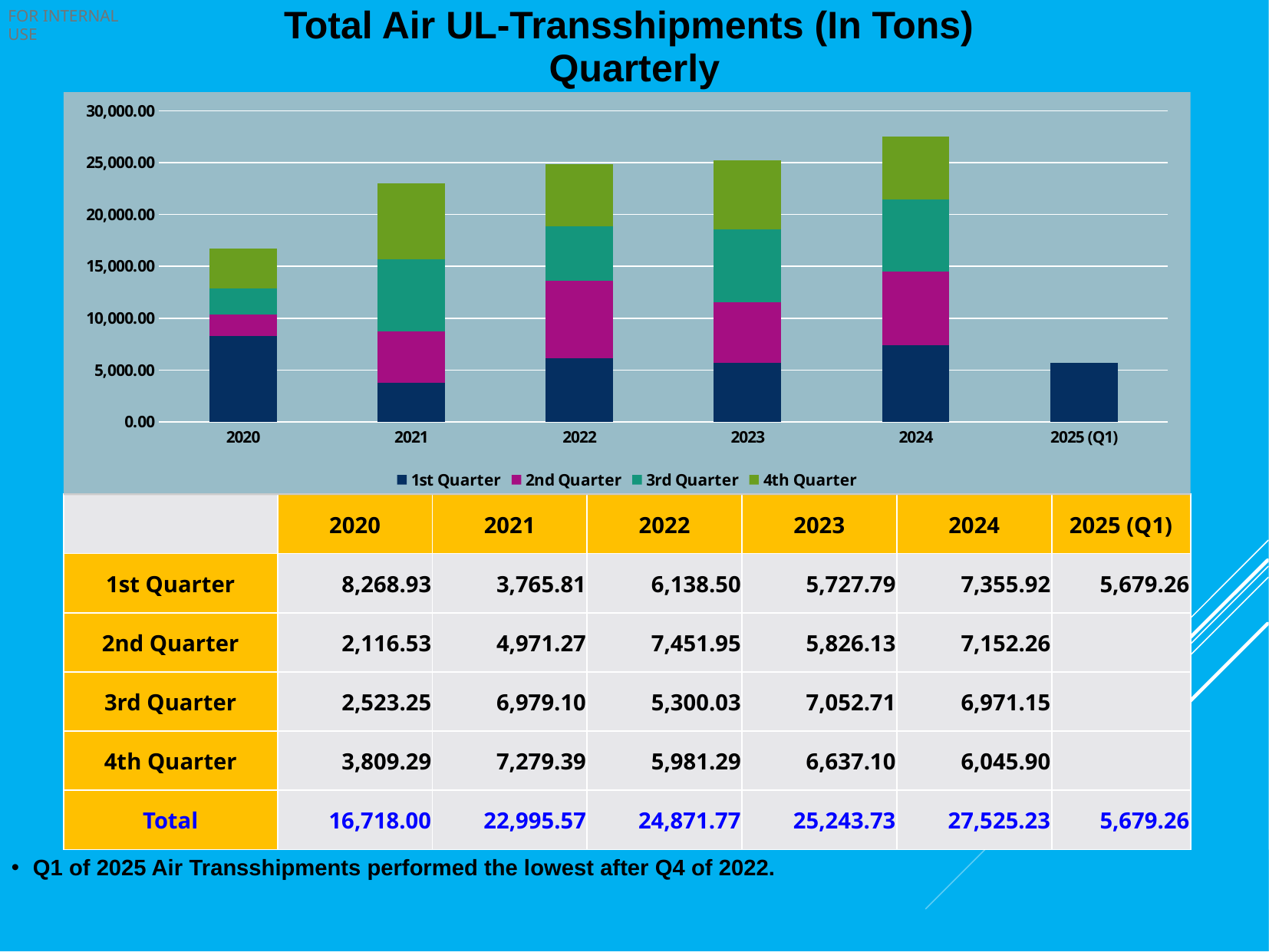
What kind of chart is shown on the slide? Stacked bar chart What colour represents the 1st Quarter series in the chart? Dark navy blue Which year has the highest total air UL-transshipments? 2024 How many year categories are shown on the x axis? 6 What is the 1st Quarter value for 2020? 8,268.93 How many series does the legend list? 4 Which category has the lowest total? 2025 (Q1) Which year has the larger 4th Quarter value, 2021 or 2022? 2021 What is the total of the stacked bar for 2024? 27,525.23 Is the total for 2020 greater or less than 20,000.00? less What is the difference between the 2nd Quarter value for 2022 and the 2nd Quarter value for 2021? 2,480.68 What is the 3rd Quarter value for 2023? 7,052.71